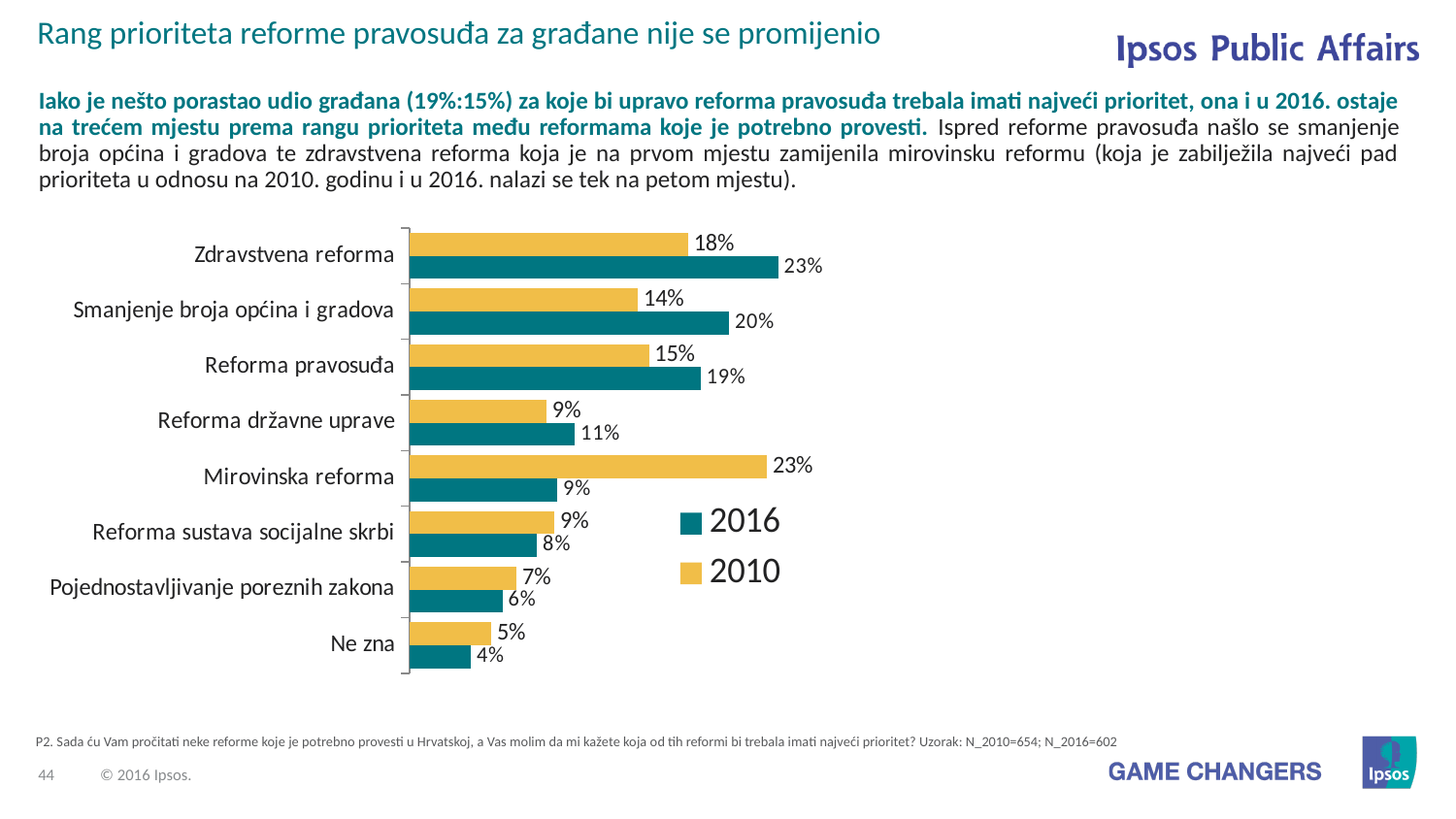
What is the 2010 value for Mirovinska reforma? 23% Which category has the lowest 2010 value? Ne zna What is the difference between the 2016 and 2010 values for Zdravstvena reforma? 5% Which category has the highest 2016 value? Zdravstvena reforma What is the 2016 value for Reforma pravosuđa? 19% How many categories are shown on the chart? 8 Which is larger for Smanjenje broja općina i gradova: the 2016 value or the 2010 value? 2016 What kind of chart is shown on the slide? Bar chart What is the difference between the 2010 and 2016 values for Mirovinska reforma? 14% What is the 2016 value for Zdravstvena reforma? 23% How many series does the legend list? 2 Which colour represents the 2010 series in the legend? Yellow